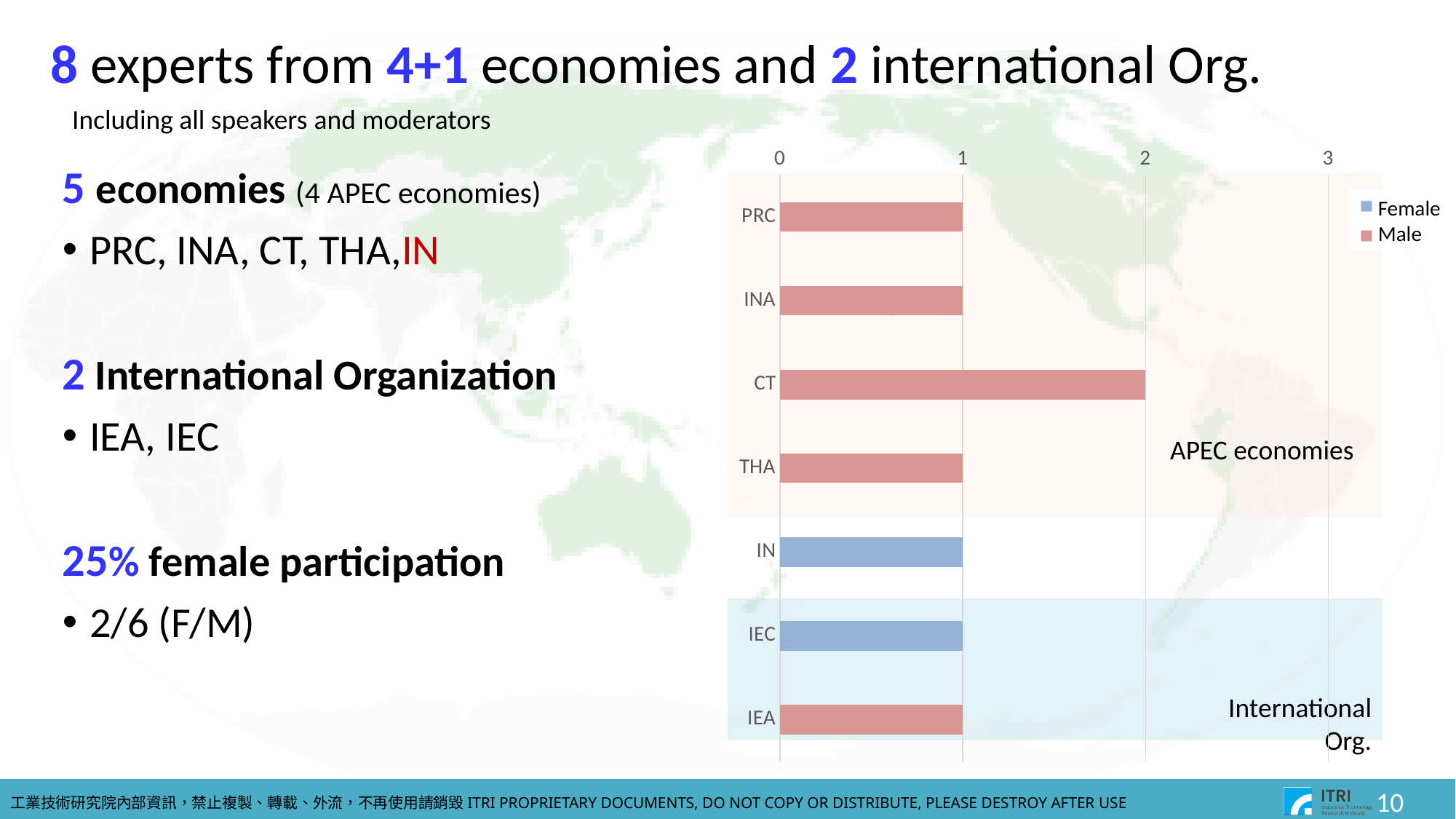
Which categories are shown with Female bars? IN and IEC Which category has the highest value in the chart? CT How many categories are plotted on the chart? 7 What kind of chart is shown on the slide? bar chart What is the difference between the values for CT and THA? 1 Which is larger, the value for CT or the value for INA? CT What are the two series named in the chart legend? Female and Male What is the value for PRC in the chart? 1 How many series does the chart legend list? 2 Which series does the bar for IN belong to? Female What is the value for CT in the chart? 2 What is the value for IEA in the chart? 1